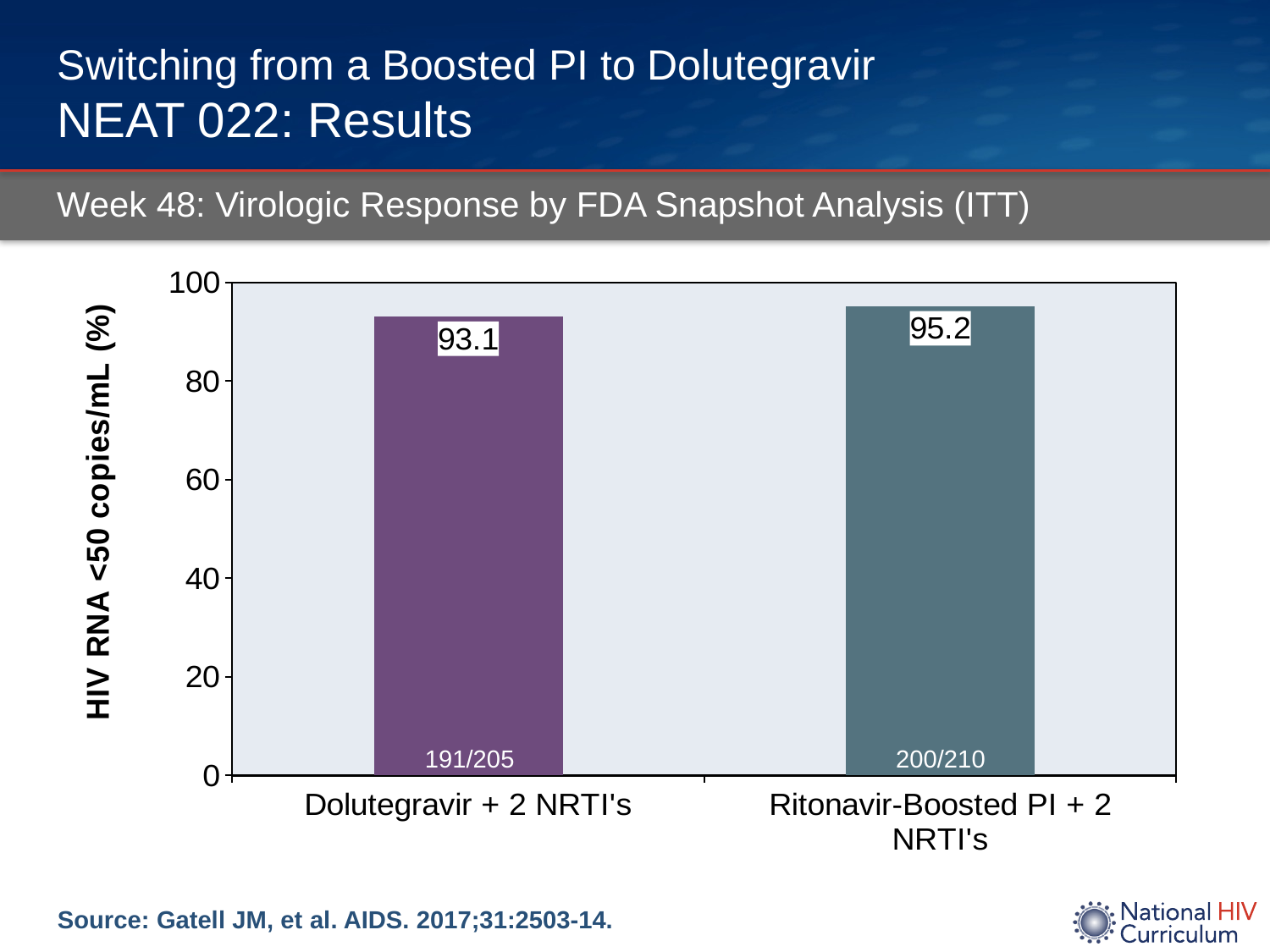
What is the y-axis label of the chart? HIV RNA <50 copies/mL (%) What kind of chart is shown on the slide? bar chart Which category has the highest value? Ritonavir-Boosted PI + 2 NRTI's Which is larger, the value for Dolutegravir + 2 NRTI's or the value for Ritonavir-Boosted PI + 2 NRTI's? Ritonavir-Boosted PI + 2 NRTI's What is the value for Dolutegravir + 2 NRTI's? 93.1 What is the difference between the values for Ritonavir-Boosted PI + 2 NRTI's and Dolutegravir + 2 NRTI's? 2.1 What fraction is printed at the base of the Ritonavir-Boosted PI + 2 NRTI's bar? 200/210 What fraction is printed at the base of the Dolutegravir + 2 NRTI's bar? 191/205 Which category has the lowest value? Dolutegravir + 2 NRTI's Is the value for Dolutegravir + 2 NRTI's greater or less than 80? greater What is the value for Ritonavir-Boosted PI + 2 NRTI's? 95.2 How many categories are shown on the chart? 2